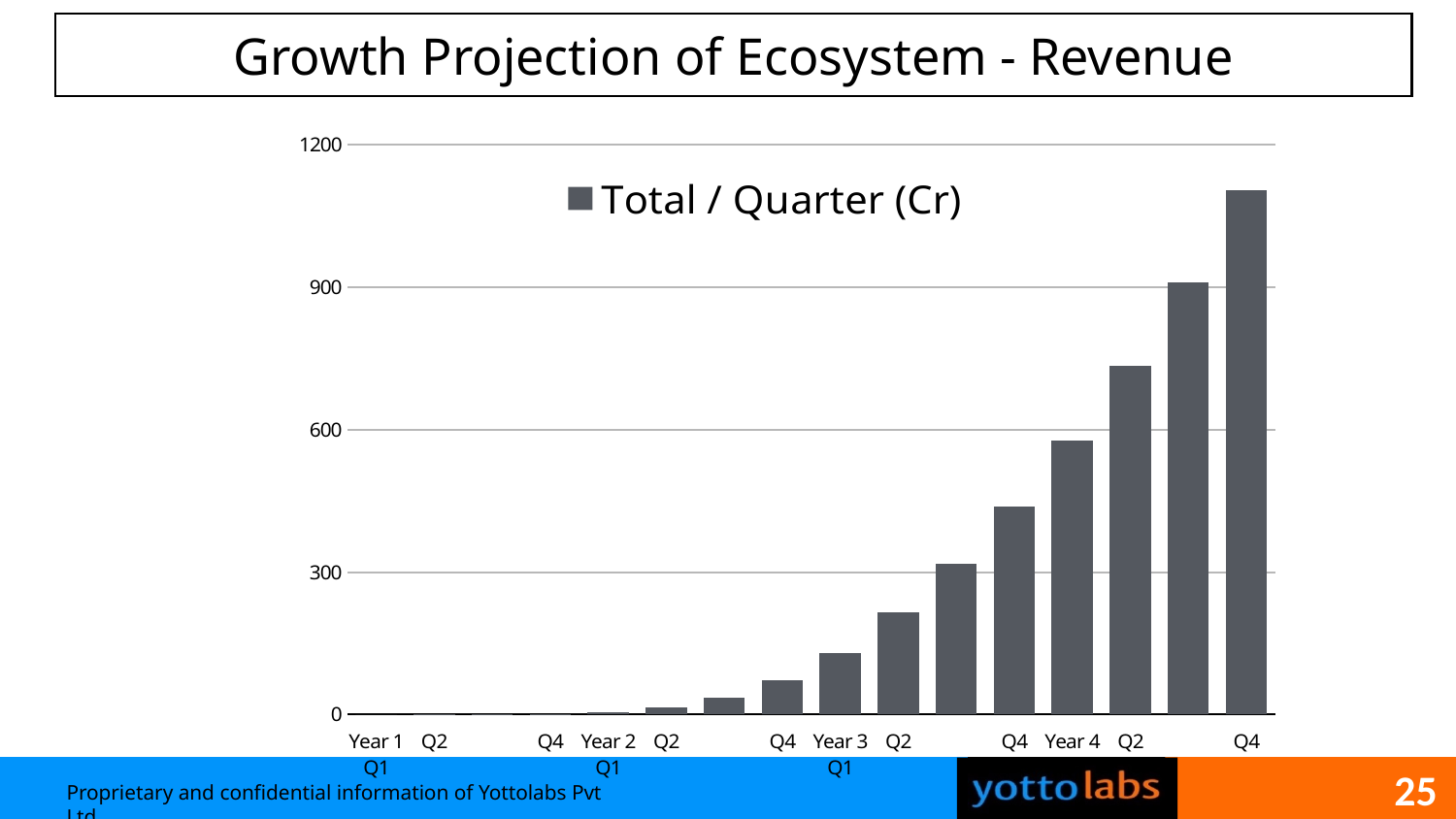
Is the value for Year 4 Q2 greater or less than 600? greater Is the value for Year 4 Q4 greater or less than 1200? less How many series does the legend list? 1 Which is larger, the value for Year 4 Q2 or the value for Year 3 Q4? Year 4 Q2 Is the value for Year 3 Q2 greater or less than 300? less What kind of chart is shown on the slide? bar chart What is the legend entry for the series plotted in the chart? Total / Quarter (Cr) Do the values rise or fall from Year 1 Q1 to Year 4 Q4? rise What is the title of the slide containing the chart? Growth Projection of Ecosystem - Revenue Which quarter has the highest value in the chart? Year 4 Q4